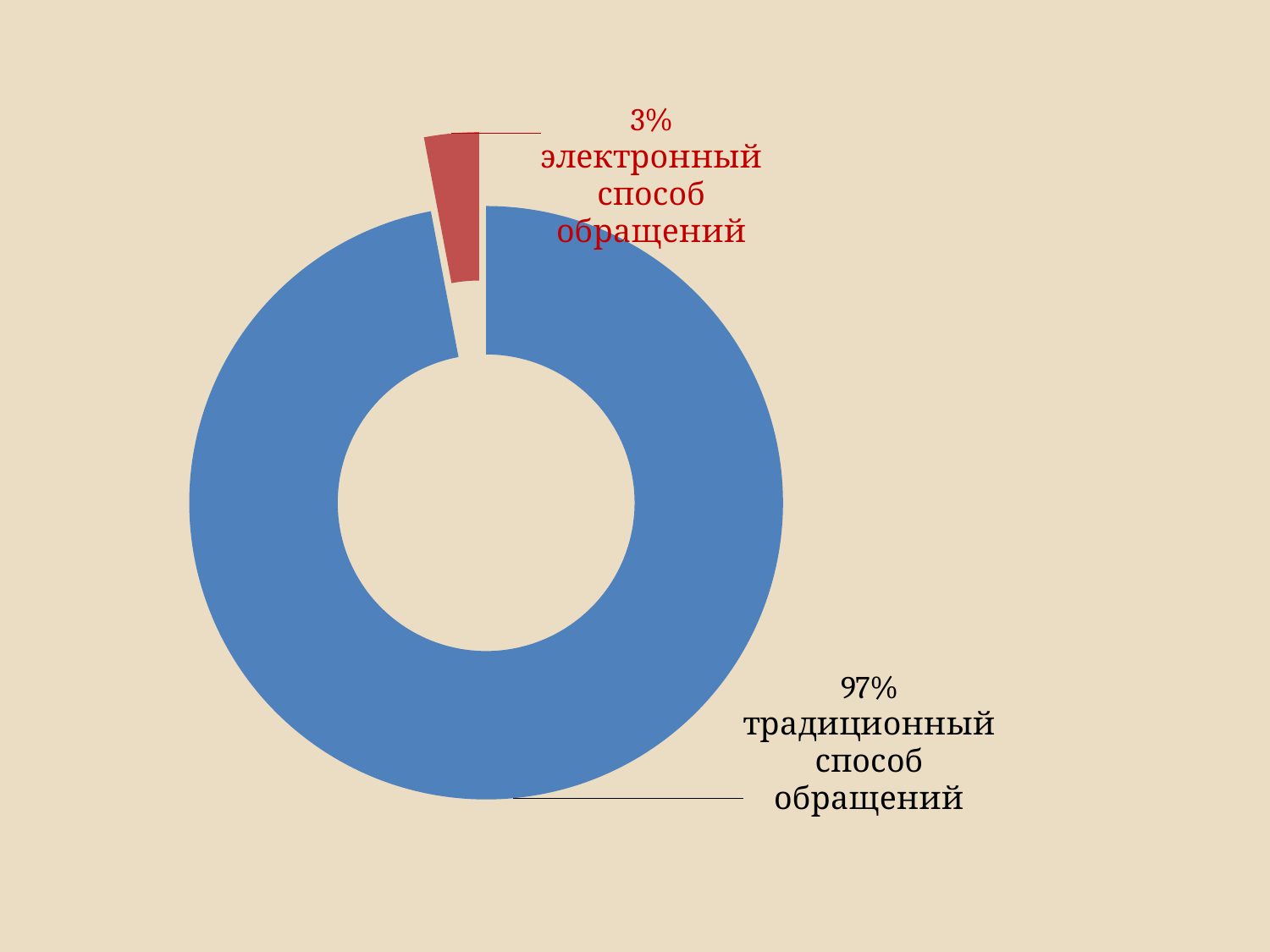
Which category has the smallest share? электронный способ обращений What share of the chart is labelled "электронный способ обращений"? 3% Which is larger: the share for "электронный способ обращений" or for "традиционный способ обращений"? традиционный способ обращений What is the total of the two shares shown? 100% What share of the chart is labelled "традиционный способ обращений"? 97% How many categories are shown in the chart? 2 What kind of chart is shown on the slide? doughnut (pie) chart Which category has the largest share? традиционный способ обращений What is the difference in percentage points between the traditional and electronic shares? 94 What colour is the slice for "электронный способ обращений"? red What colour is the slice for "традиционный способ обращений"? blue